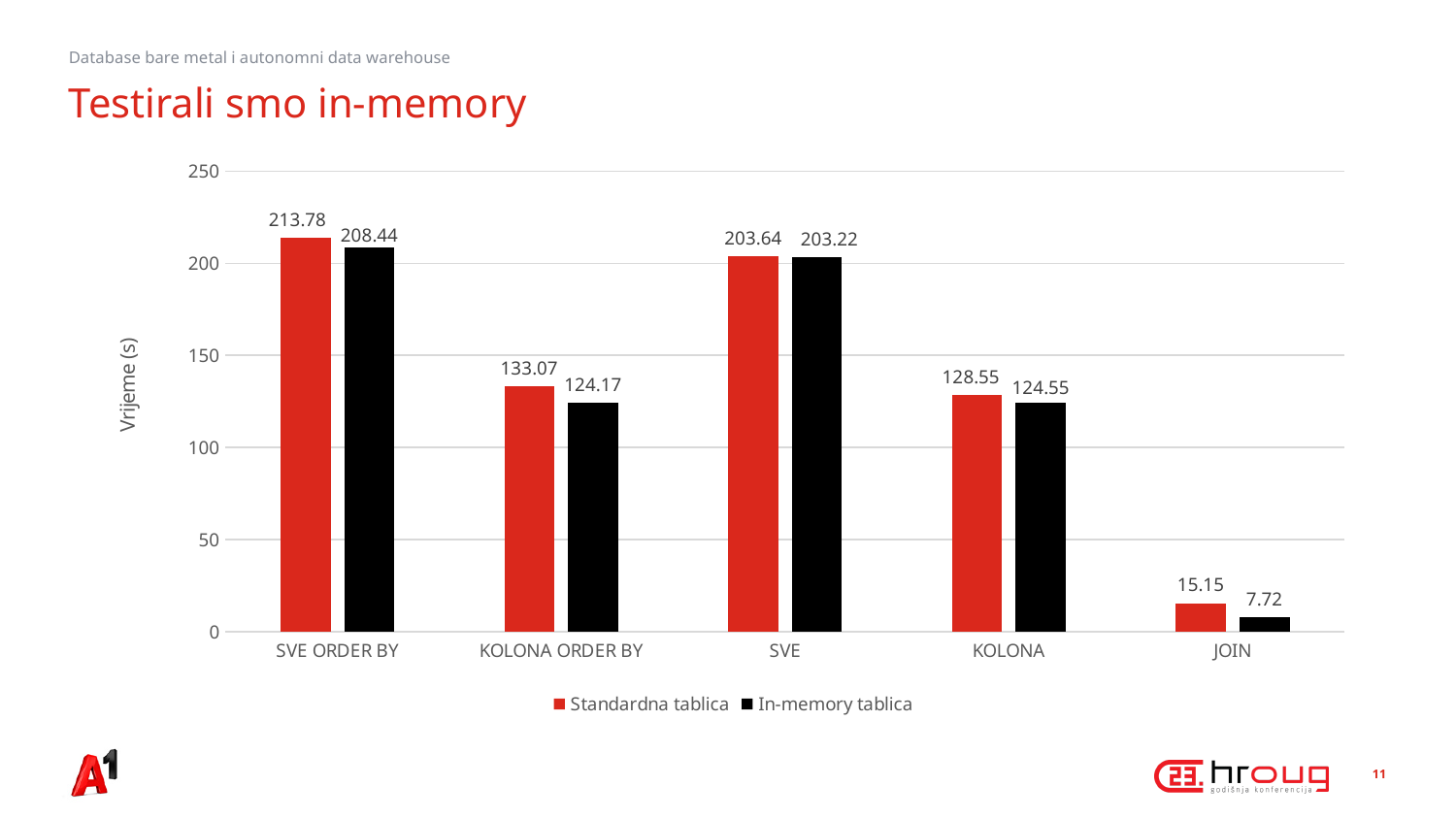
What is the value for In-memory tablica in the JOIN category? 7.72 What is the difference between Standardna tablica and In-memory tablica in the KOLONA ORDER BY category? 8.90 What is the value for Standardna tablica in the SVE ORDER BY category? 213.78 Which category has the lowest value for In-memory tablica? JOIN What kind of chart is shown on the slide? bar chart What is the label of the y axis? Vrijeme (s) How many categories are shown on the x axis? 5 Which is larger in the JOIN category: Standardna tablica or In-memory tablica? Standardna tablica Which category has the highest value for Standardna tablica? SVE ORDER BY How many series does the legend list? 2 Is the value for Standardna tablica in the KOLONA category greater or less than 100? greater What is the value for In-memory tablica in the KOLONA ORDER BY category? 124.17